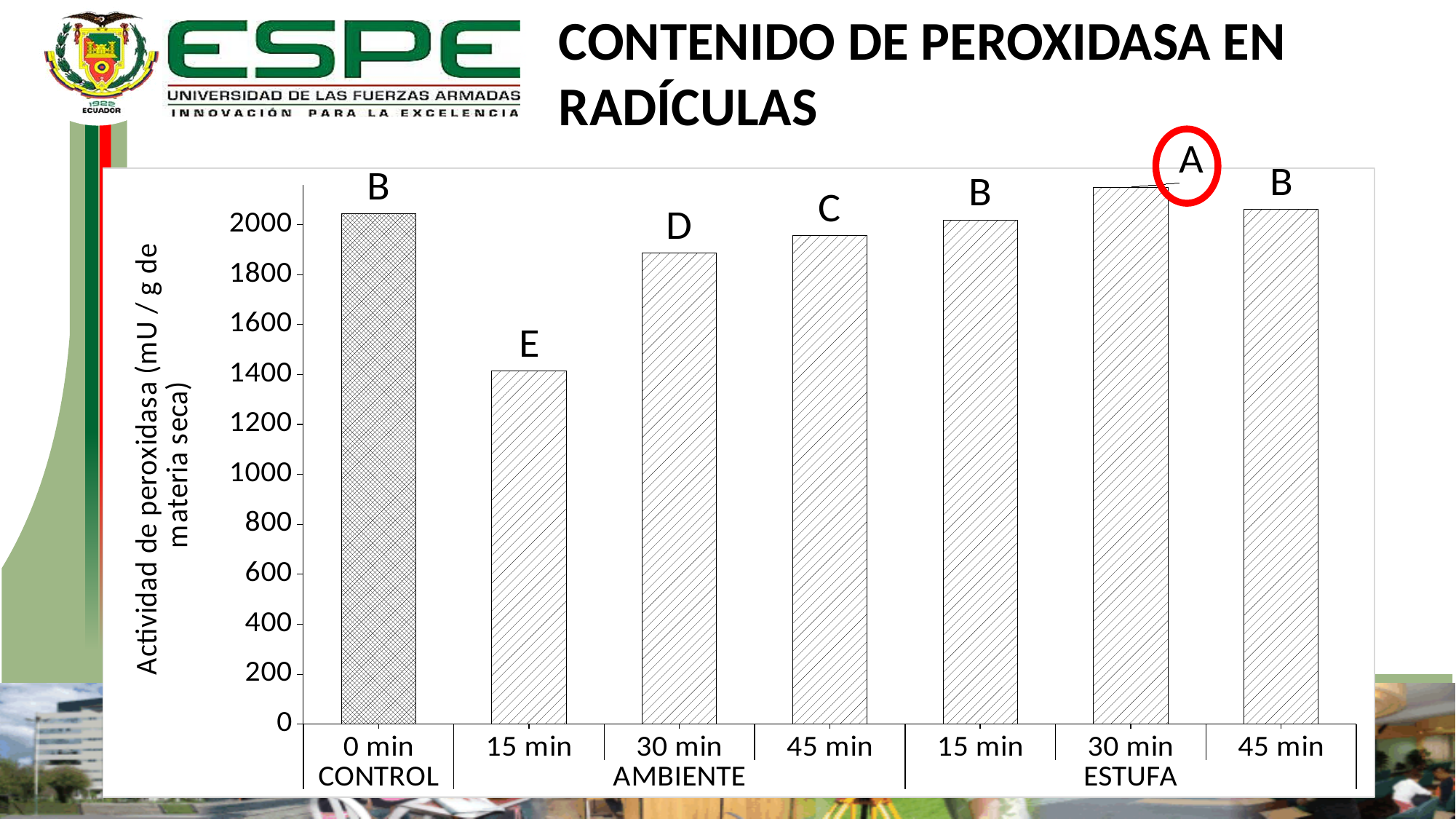
Which is larger, the value for 30 min AMBIENTE or the value for 45 min AMBIENTE? 45 min AMBIENTE Is the value for 15 min AMBIENTE greater or less than 1600? less Which bar has the lowest peroxidase activity? 15 min AMBIENTE Which is larger, the value for 15 min AMBIENTE or the value for 30 min AMBIENTE? 30 min AMBIENTE Which bar has the highest peroxidase activity? 30 min ESTUFA Is the value for 30 min ESTUFA greater or less than 2000? greater What kind of chart is shown on the slide? bar chart How many treatment groups are labelled along the x axis (CONTROL, AMBIENTE, ESTUFA)? 3 Is the value for 30 min AMBIENTE greater or less than 2000? less Which letter is printed above the 30 min ESTUFA bar and circled in red? A What is the y-axis title of the chart? Actividad de peroxidasa (mU / g de materia seca) How many bars are plotted in the chart? 7